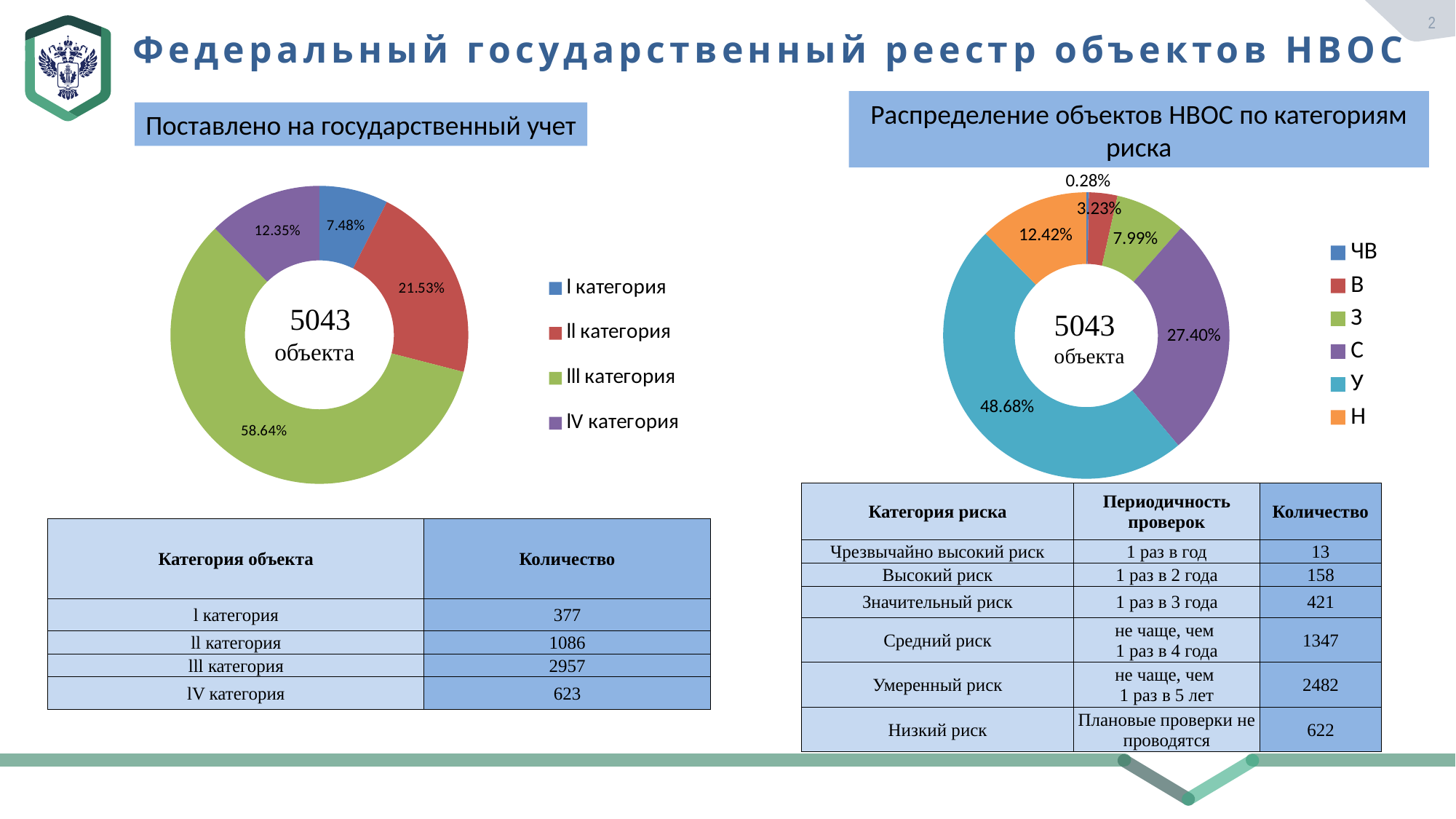
In the right chart 'Распределение объектов НВОС по категориям риска', which category has the largest slice? У In the right chart 'Распределение объектов НВОС по категориям риска', how many categories does the legend list? 6 In the right chart 'Распределение объектов НВОС по категориям риска', which is larger, С or Н? С In the left chart 'Поставлено на государственный учет', what share is shown for lll категория? 58.64% In the left chart 'Поставлено на государственный учет', which category has the smallest slice? l категория In the right chart 'Распределение объектов НВОС по категориям риска', what share is shown for У? 48.68% In the left chart 'Поставлено на государственный учет', which category has the largest slice? lll категория In the left chart 'Поставлено на государственный учет', what share is shown for l категория? 7.48% In the left chart 'Поставлено на государственный учет', what is the difference in percentage points between ll категория and lV категория? 9.18 What type of chart is used in 'Распределение объектов НВОС по категориям риска'? Doughnut chart In the left chart 'Поставлено на государственный учет', how many categories does the legend list? 4 In the right chart 'Распределение объектов НВОС по категориям риска', what share is shown for ЧВ? 0.28%